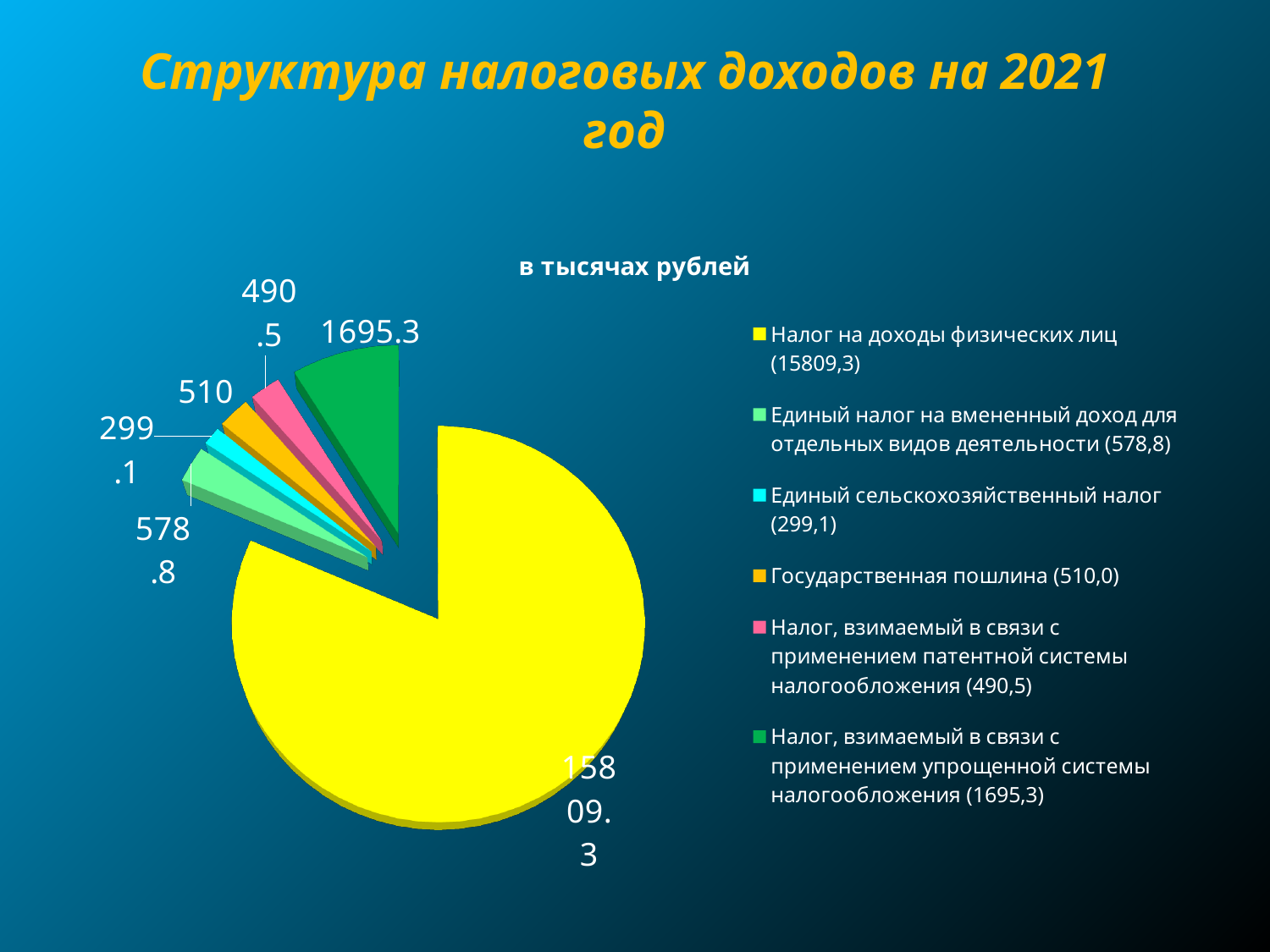
What is the title of the chart? в тысячах рублей How many slices does the pie chart have? 6 What is the value for Налог, взимаемый в связи с применением упрощенной системы налогообложения? 1695.3 What colour is the slice for Единый сельскохозяйственный налог? cyan What kind of chart is shown on the slide? pie chart What is the value for Государственная пошлина? 510 What is the difference between the value for Налог, взимаемый в связи с применением упрощенной системы налогообложения and the value for Единый налог на вмененный доход для отдельных видов деятельности? 1116.5 Which is larger: the value for Государственная пошлина or the value for Налог, взимаемый в связи с применением патентной системы налогообложения? Государственная пошлина Which category has the smallest slice of the pie? Единый сельскохозяйственный налог What is the value for Налог на доходы физических лиц? 15809.3 Which category has the largest slice of the pie? Налог на доходы физических лиц What is the value for Единый сельскохозяйственный налог? 299.1